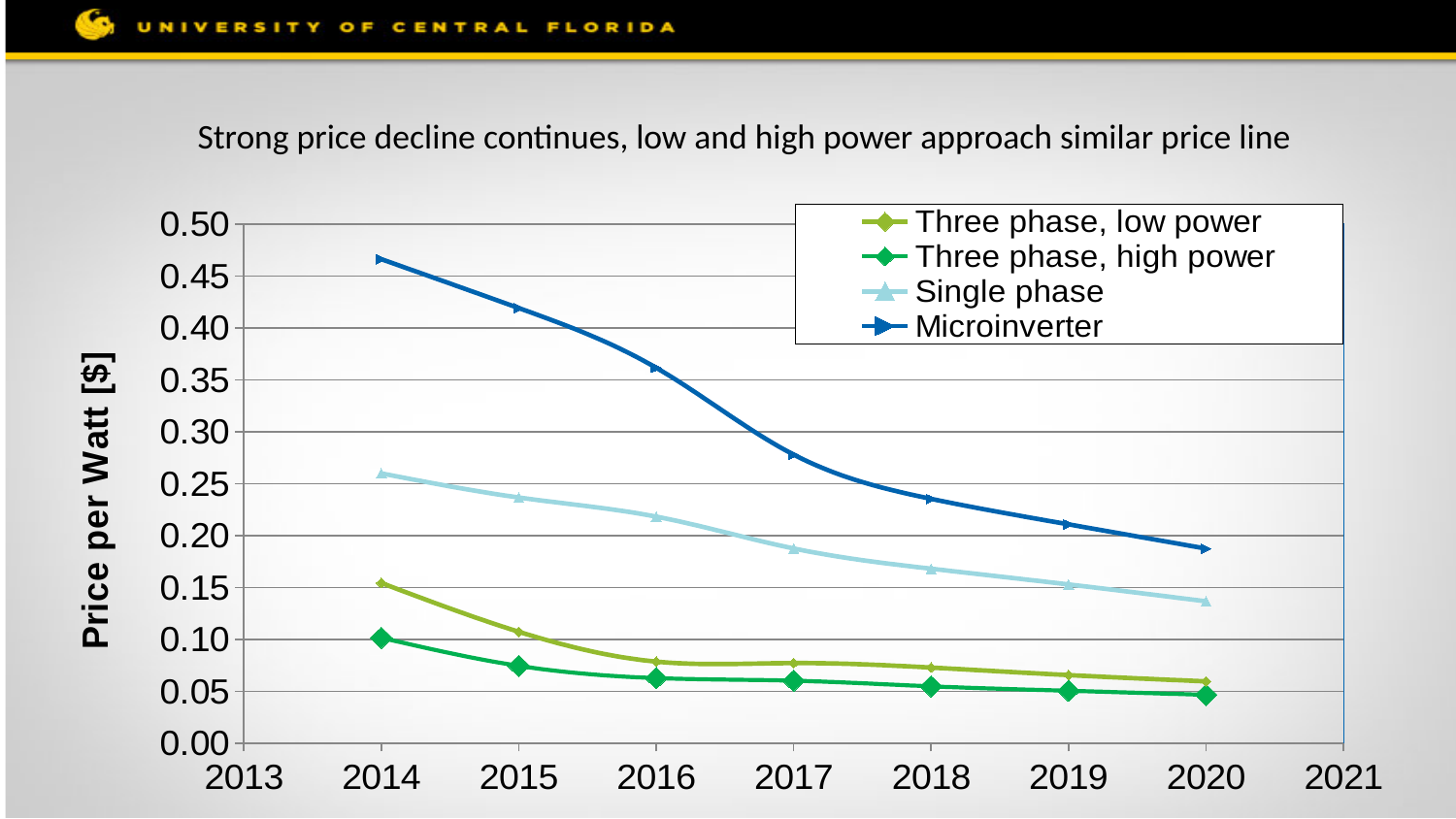
Which series has the lowest price per watt in 2020? Three phase, high power How many years are plotted for each series? 7 Which is larger in 2016: the Single phase price per watt or the Three phase, low power price per watt? Single phase What is the label of the y axis? Price per Watt [$] Is the Microinverter price per watt in 2017 greater or less than 0.30? less Is the Single phase price per watt in 2014 greater or less than 0.20? greater How many series does the legend list? 4 What kind of chart is shown on the slide? line chart Does the Microinverter price per watt rise or fall from 2014 to 2020? fall Is the Microinverter price per watt in 2014 greater or less than 0.45? greater Which series has the highest price per watt in 2014? Microinverter